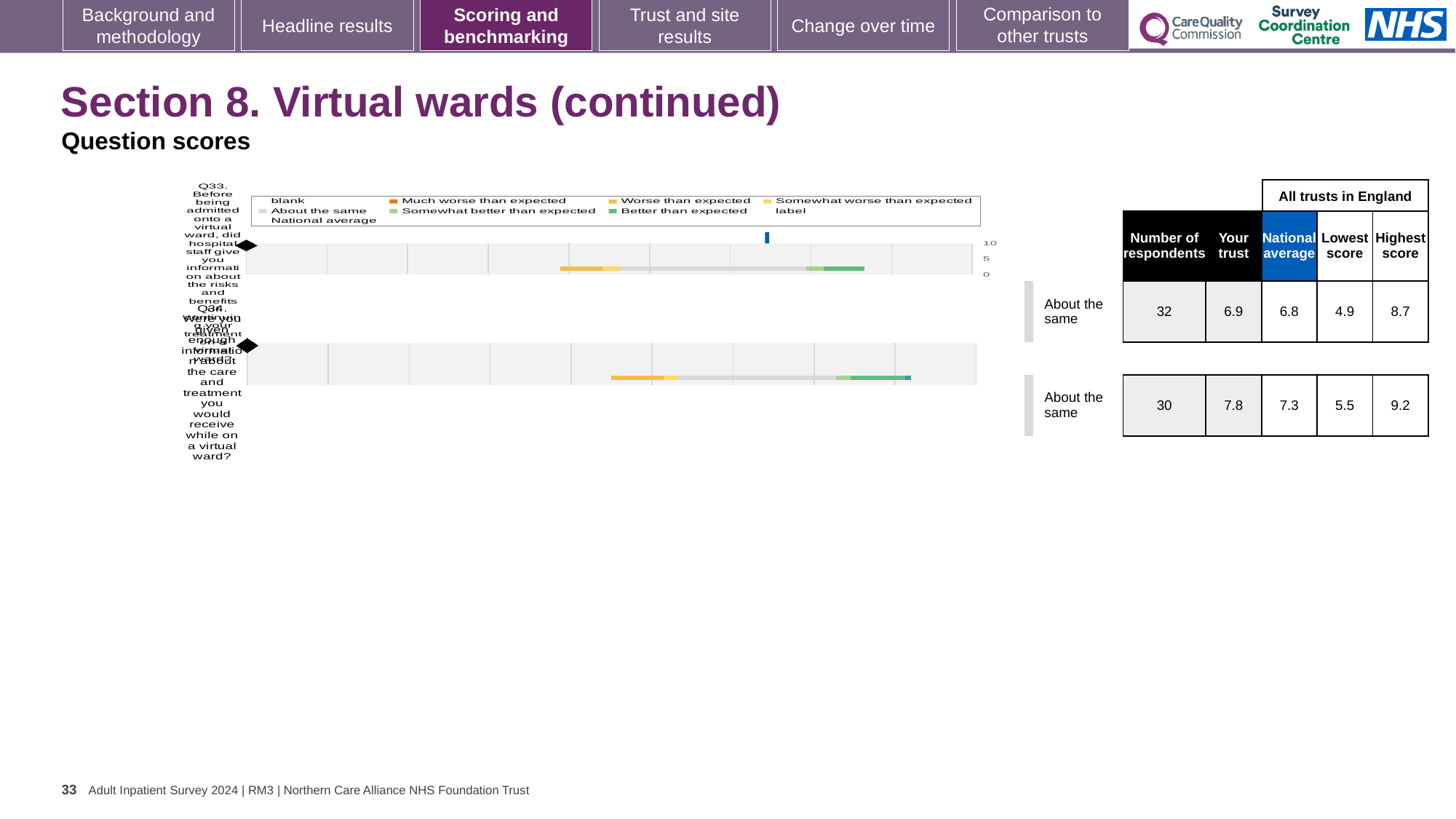
What is the lowest score among all trusts in England for Q34? 5.5 What benchmark category is shown for Q33? About the same What kind of chart is shown on the slide? bar chart How many respondents answered Q33? 32 What is the national average score for Q34? 7.3 What is the difference between the highest and lowest scores for Q33? 3.8 Which question has the higher 'Highest score' value? Q34 Which question has the higher 'Your trust' score, Q33 or Q34? Q34 What is the 'Your trust' score for Q34? 7.8 How many questions (bars) are plotted in the chart? 2 What is the 'Your trust' score for Q33? 6.9 What is the difference between the 'Your trust' score and the national average for Q34? 0.5